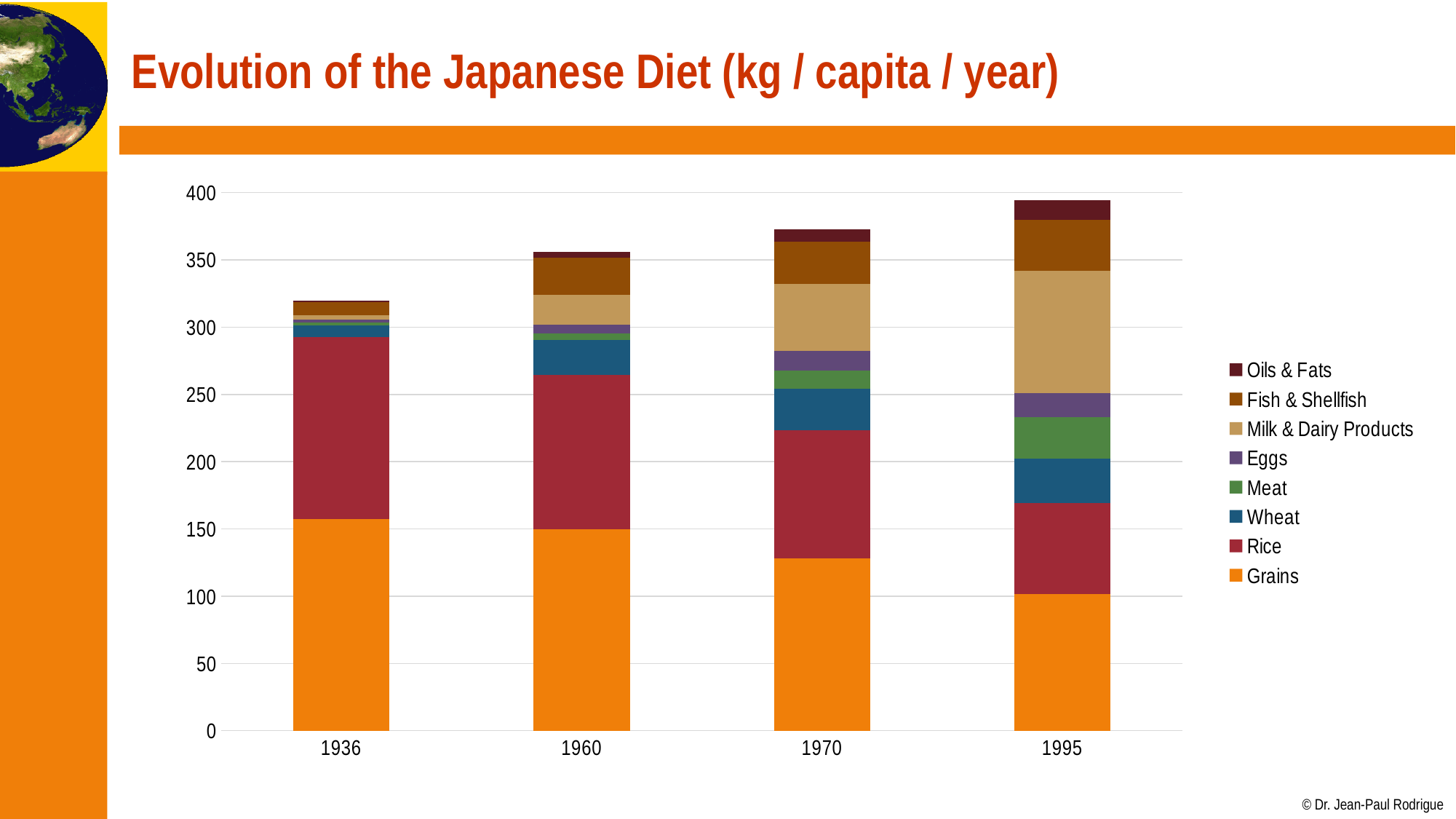
How many years (categories) are shown on the x axis? 4 Is the total for 1936 greater or less than 350? less Which year has the tallest stacked bar (largest total)? 1995 Which year has the shortest stacked bar (smallest total)? 1936 Is the Grains value for 1995 greater or less than 150? less Does the total height of the stacked bars rise or fall from 1936 to 1995? rise Which series is shown in orange at the bottom of each bar? Grains What is the title of the chart on the slide? Evolution of the Japanese Diet (kg / capita / year) What kind of chart is shown on the slide? stacked bar chart Is the total for 1995 greater or less than 350? greater Which year has the larger Grains segment, 1936 or 1995? 1936 How many series does the legend list? 8